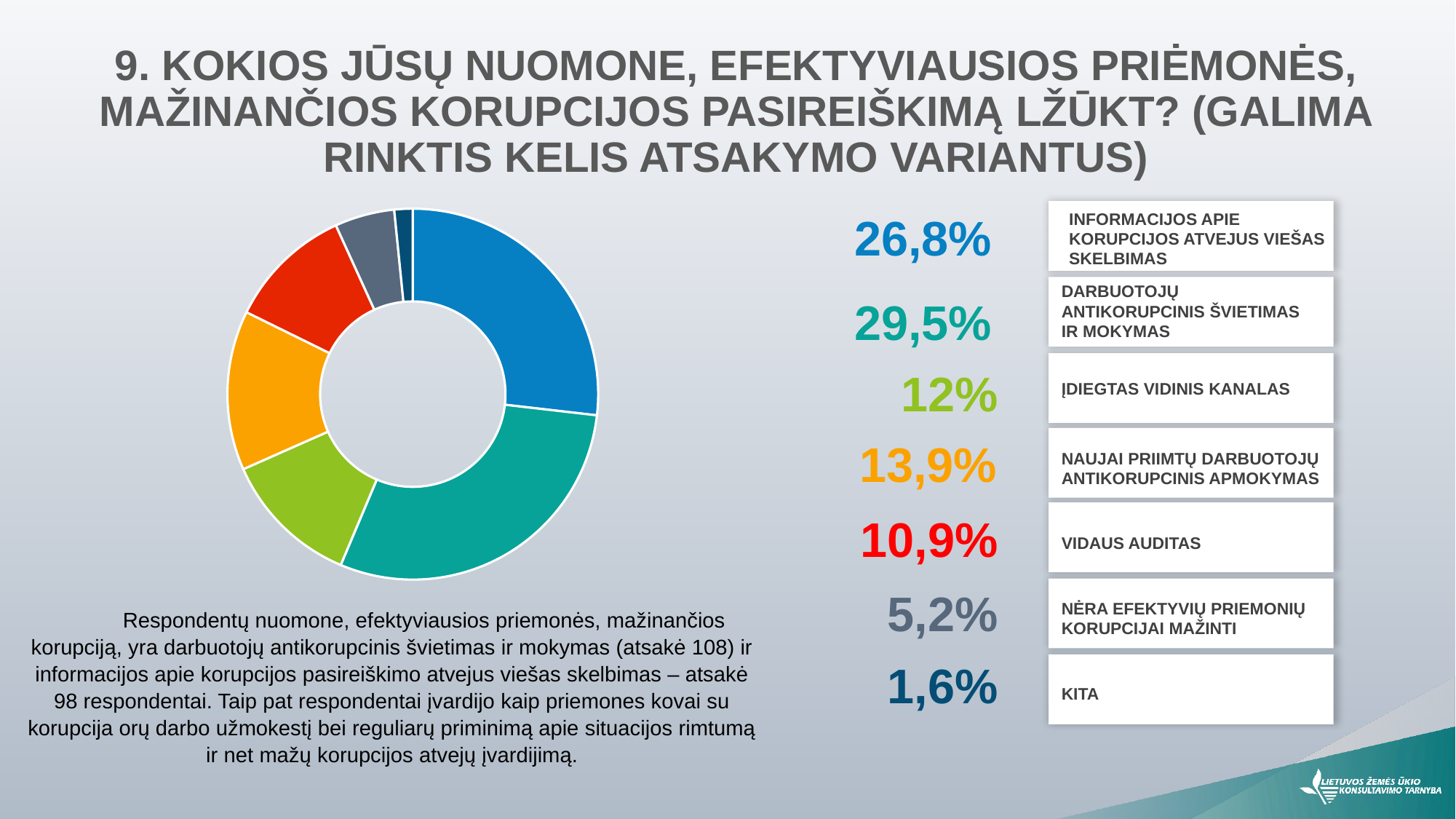
Which category has the lowest share? Kita What is the difference between "Nėra efektyvių priemonių korupcijai mažinti" and "Kita"? 3,6% Which category has the highest share? Darbuotojų antikorupcinis švietimas ir mokymas What is the value for "Vidaus auditas"? 10,9% What is the value for "Darbuotojų antikorupcinis švietimas ir mokymas"? 29,5% What is the value for "Kita"? 1,6% What is the difference between "Darbuotojų antikorupcinis švietimas ir mokymas" and "Informacijos apie korupcijos atvejus viešas skelbimas"? 2,7% How many categories does the chart show? 7 What is the value for "Įdiegtas vidinis kanalas"? 12% What colour represents "Vidaus auditas" in the chart? red Which is larger: "Naujai priimtų darbuotojų antikorupcinis apmokymas" or "Vidaus auditas"? Naujai priimtų darbuotojų antikorupcinis apmokymas What kind of chart is shown on the slide? doughnut (pie) chart